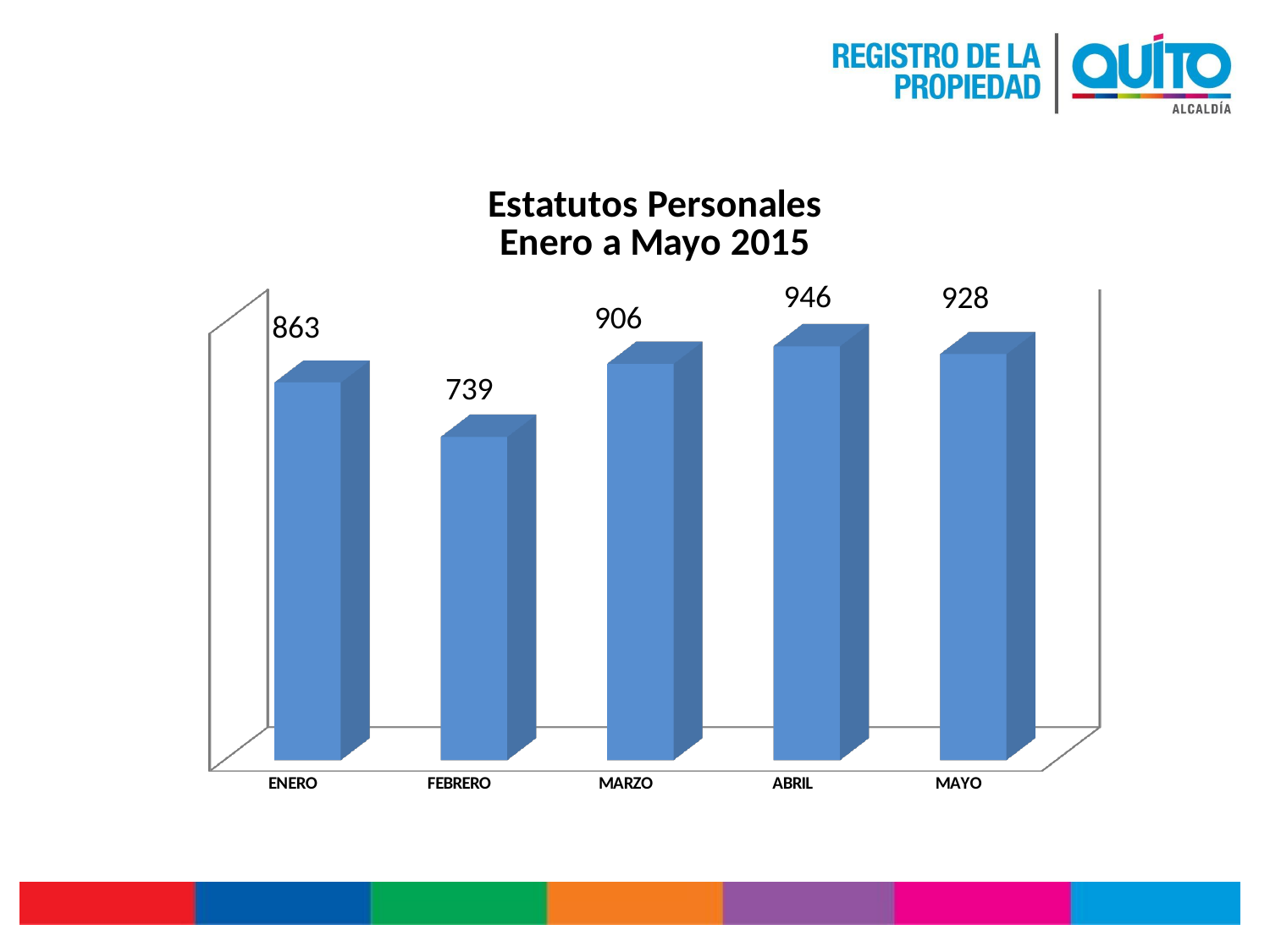
What is the difference between the values for MAYO and ENERO? 65 What is the value for MAYO? 928 What is the value for FEBRERO? 739 Which month has the lowest value? FEBRERO Which month has the highest value? ABRIL What is the difference between the values for ABRIL and FEBRERO? 207 How many months are shown on the chart? 5 What is the value for ENERO? 863 Which is larger, the value for MARZO or the value for ENERO? MARZO What is the value for MARZO? 906 What kind of chart is shown on the slide? bar chart What is the title of the chart? Estatutos Personales Enero a Mayo 2015